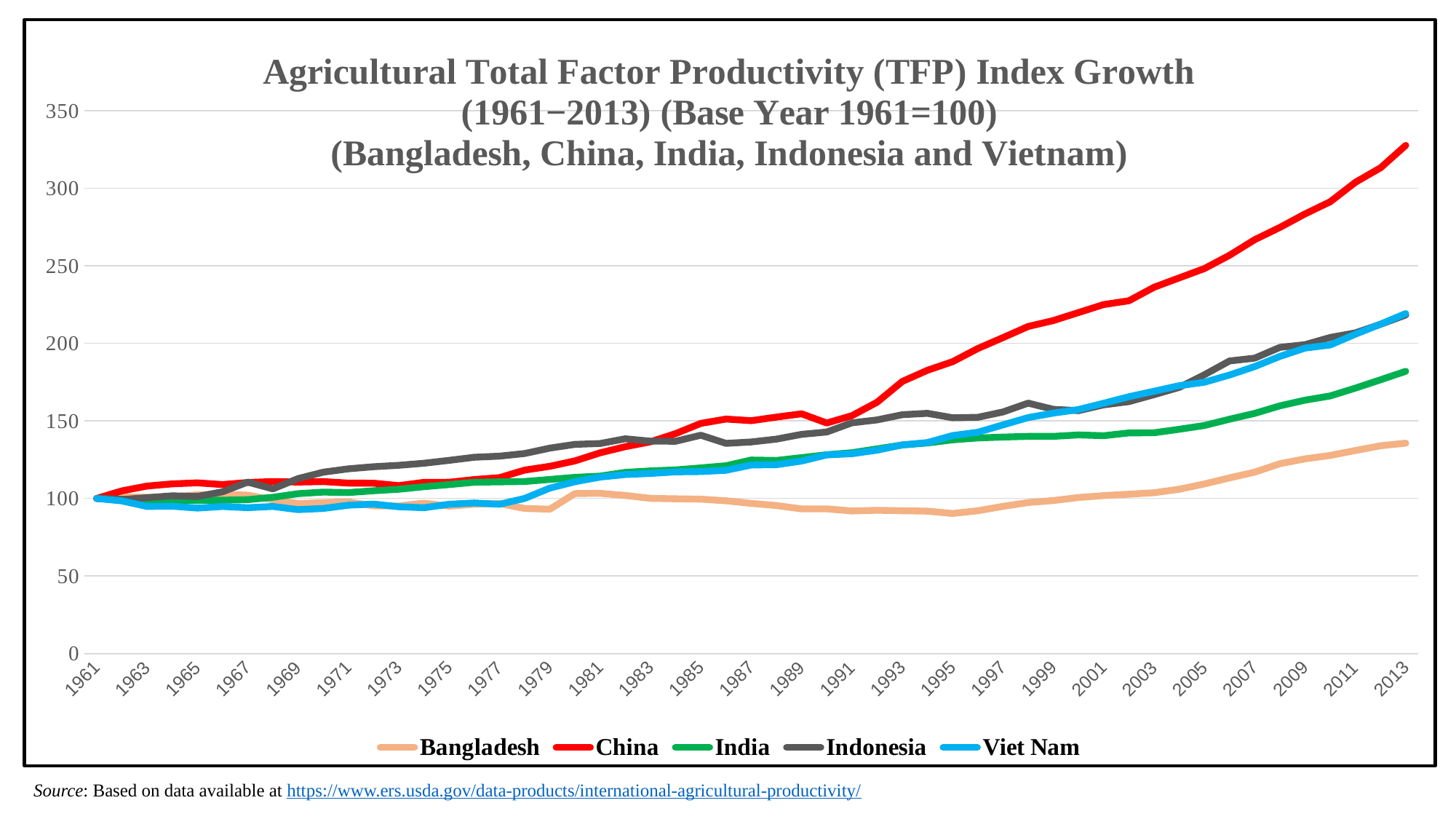
Is the value for Bangladesh in 2013 greater or less than 150? less How many series does the legend list? 5 What kind of chart is shown on the slide? line chart Does the TFP index for China rise or fall from 1961 to 2013? rises In 2013, which is larger: the value for India or the value for Indonesia? Indonesia Which colour represents China in the legend? red Is the value for China in 2013 greater or less than 300? greater What is the TFP index value for all countries in the base year 1961? 100 Is the value for Bangladesh in 1995 greater or less than 100? less Which country has the lowest TFP index value in 2013? Bangladesh Which country has the highest TFP index value in 2013? China